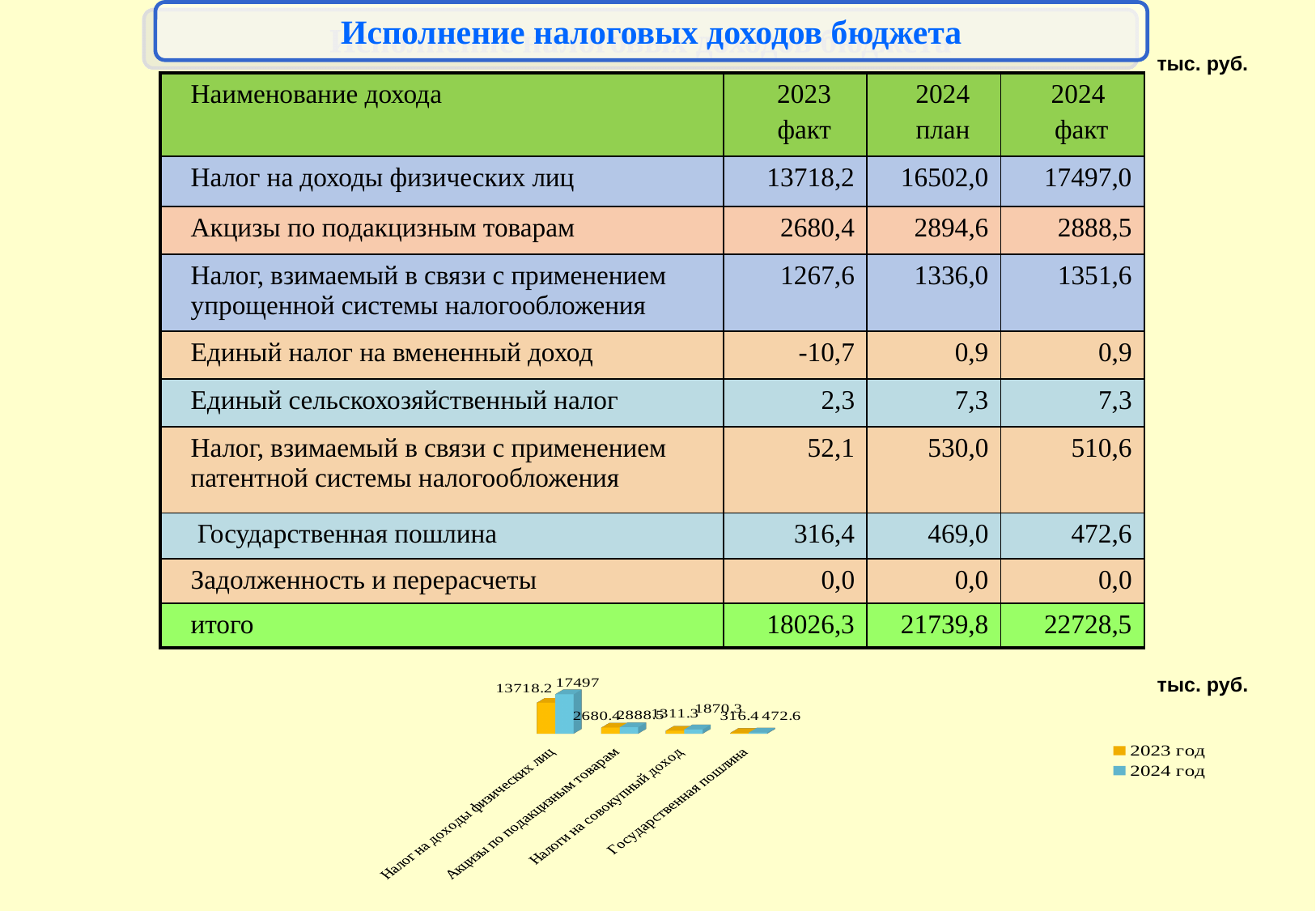
In the bar chart, which is larger for Налоги на совокупный доход: the 2023 год value or the 2024 год value? 2024 год In the bar chart, what is the value for Налог на доходы физических лиц for 2024 год? 17497 In the bar chart, what is the value for Государственная пошлина for 2024 год? 472.6 How many categories are shown on the x axis of the bar chart? 4 In the bar chart, what is the value for Государственная пошлина for 2023 год? 316.4 What are the two legend entries of the bar chart? 2023 год, 2024 год How many series does the legend of the bar chart list? 2 In the bar chart, which category has the lowest value for 2023 год? Государственная пошлина In the bar chart, what is the value for Налог на доходы физических лиц for 2023 год? 13718.2 In the bar chart, which category has the highest value for 2024 год? Налог на доходы физических лиц What kind of chart is shown at the bottom of the slide? bar chart In the bar chart, what is the value for Налоги на совокупный доход for 2024 год? 1870.3